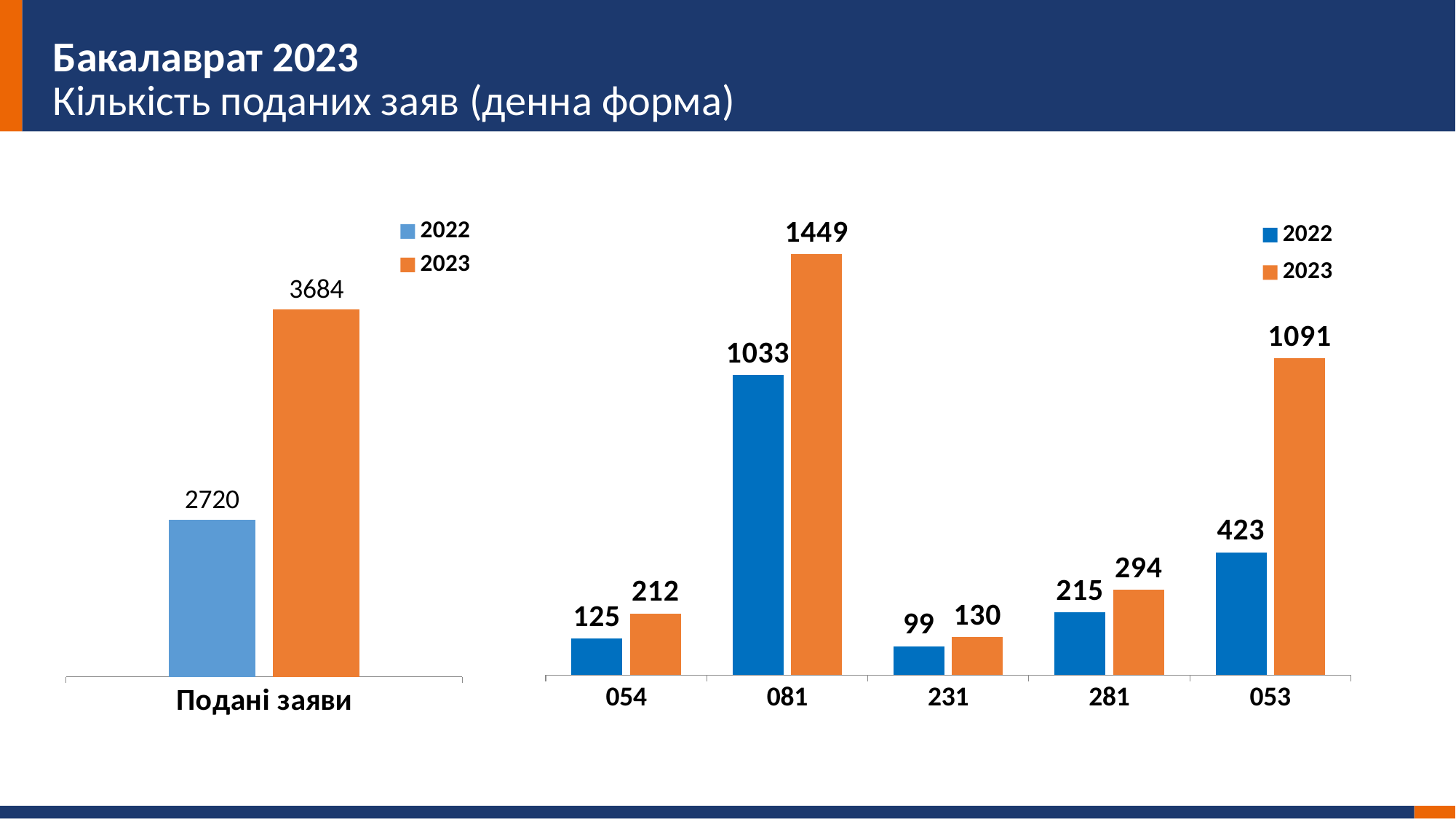
In the left chart (Подані заяви), what is the difference between the 2023 and 2022 values? 964 In the right chart, what is the 2022 value for category 053? 423 How many series does the legend of the right chart list? 2 In the right chart, what is the difference between the 2023 and 2022 values for category 053? 668 In the left chart (Подані заяви), what is the value for 2023? 3684 In the right chart, which category has the lowest 2022 value? 231 In the right chart, what is the 2023 value for category 081? 1449 What kind of chart is the right chart? bar chart In the right chart, which category has the highest 2023 value? 081 In the left chart (Подані заяви), what is the value for 2022? 2720 In the right chart, which is larger: the 2023 value for 054 or the 2023 value for 281? 281 How many categories are shown on the x axis of the right chart? 5